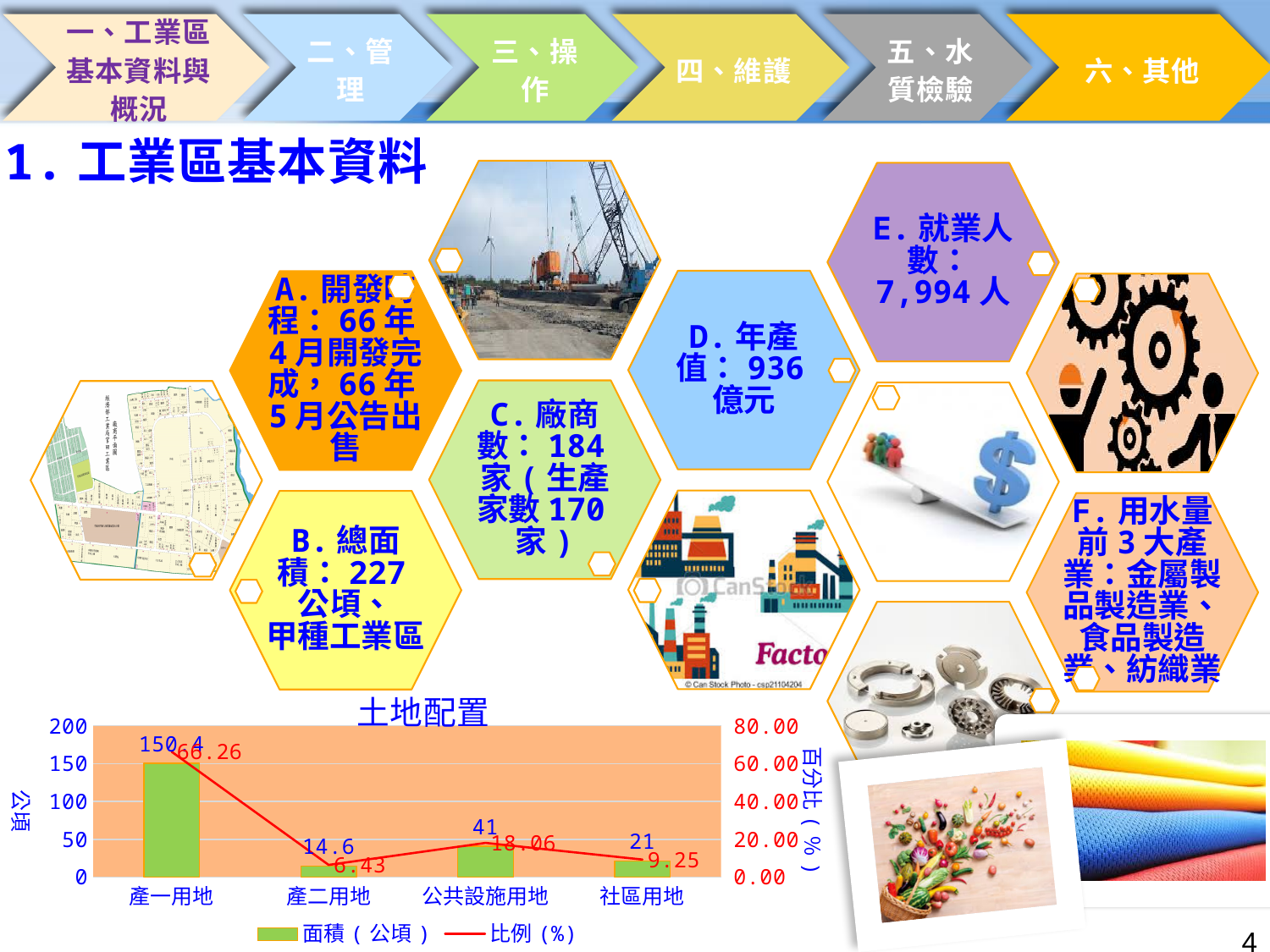
How many series does the legend of the 土地配置 chart list? 2 What is the title of the chart at the bottom of the slide? 土地配置 In the 土地配置 chart, what is the 比例(%) value for 產二用地? 6.43 What kind of chart is the 土地配置 chart? Combination bar and line chart In the 土地配置 chart, what is the 比例(%) value for 公共設施用地? 18.06 In the 土地配置 chart, which category has the lowest 比例(%)? 產二用地 In the 土地配置 chart, what is the 面積（公頃） value for 社區用地? 21 In the 土地配置 chart, what is the 面積（公頃） value for 產一用地? 150.4 In the 土地配置 chart, what is the difference in 面積（公頃） between 公共設施用地 and 社區用地? 20 In the 土地配置 chart, which has a larger 面積（公頃）: 產二用地 or 社區用地? 社區用地 How many categories are shown on the x axis of the 土地配置 chart? 4 In the 土地配置 chart, which category has the highest 面積（公頃）? 產一用地